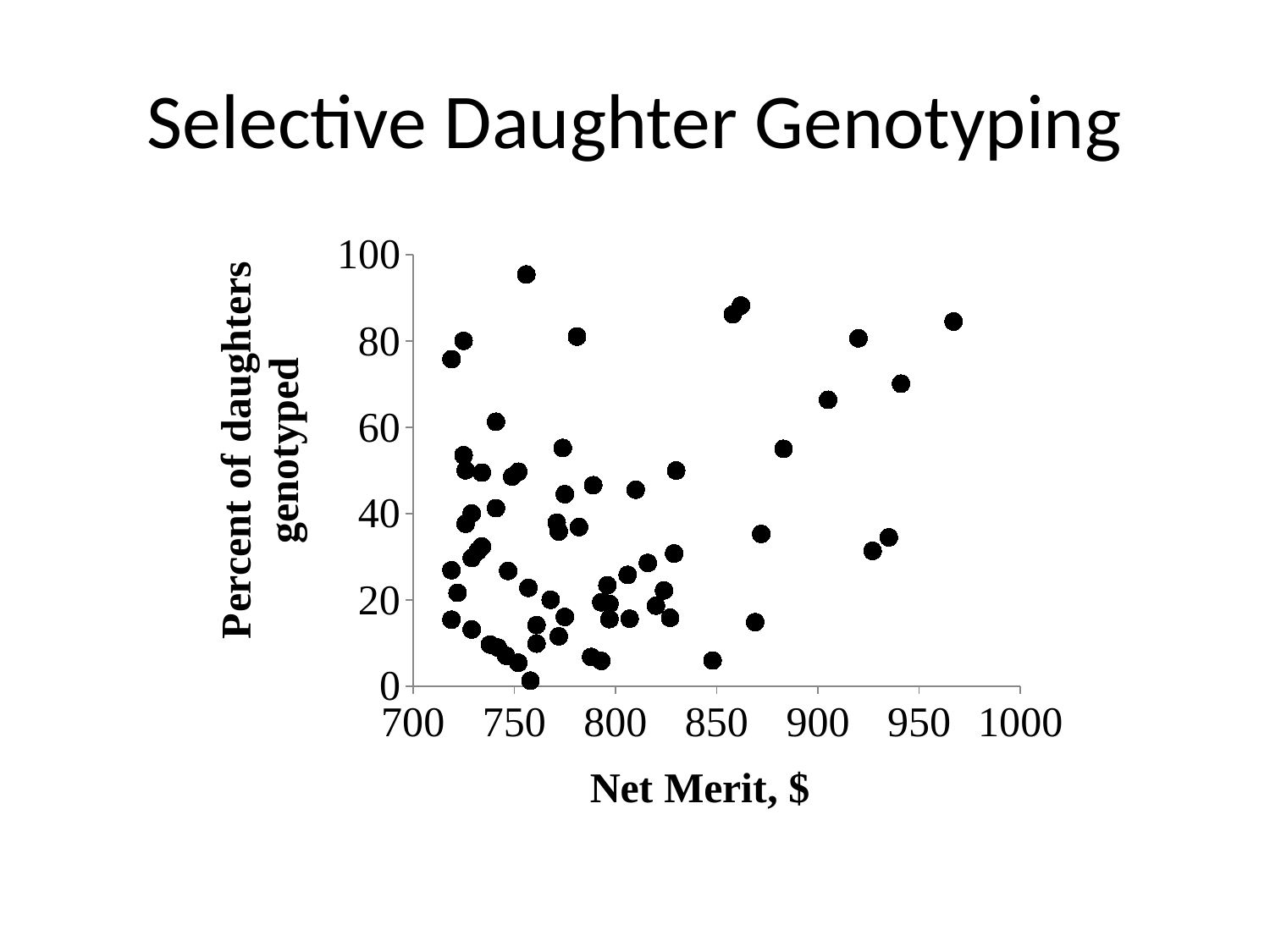
Is the lowest percent of daughters genotyped plotted on the chart greater or less than 20? less Are there any points plotted with a Net Merit below 700? no What is the title of the y axis? Percent of daughters genotyped Is the Net Merit of the rightmost point greater or less than 950? greater What is the title of the x axis? Net Merit, $ Is the highest percent of daughters genotyped plotted on the chart greater or less than 90? greater What kind of chart is shown on the slide? scatter plot